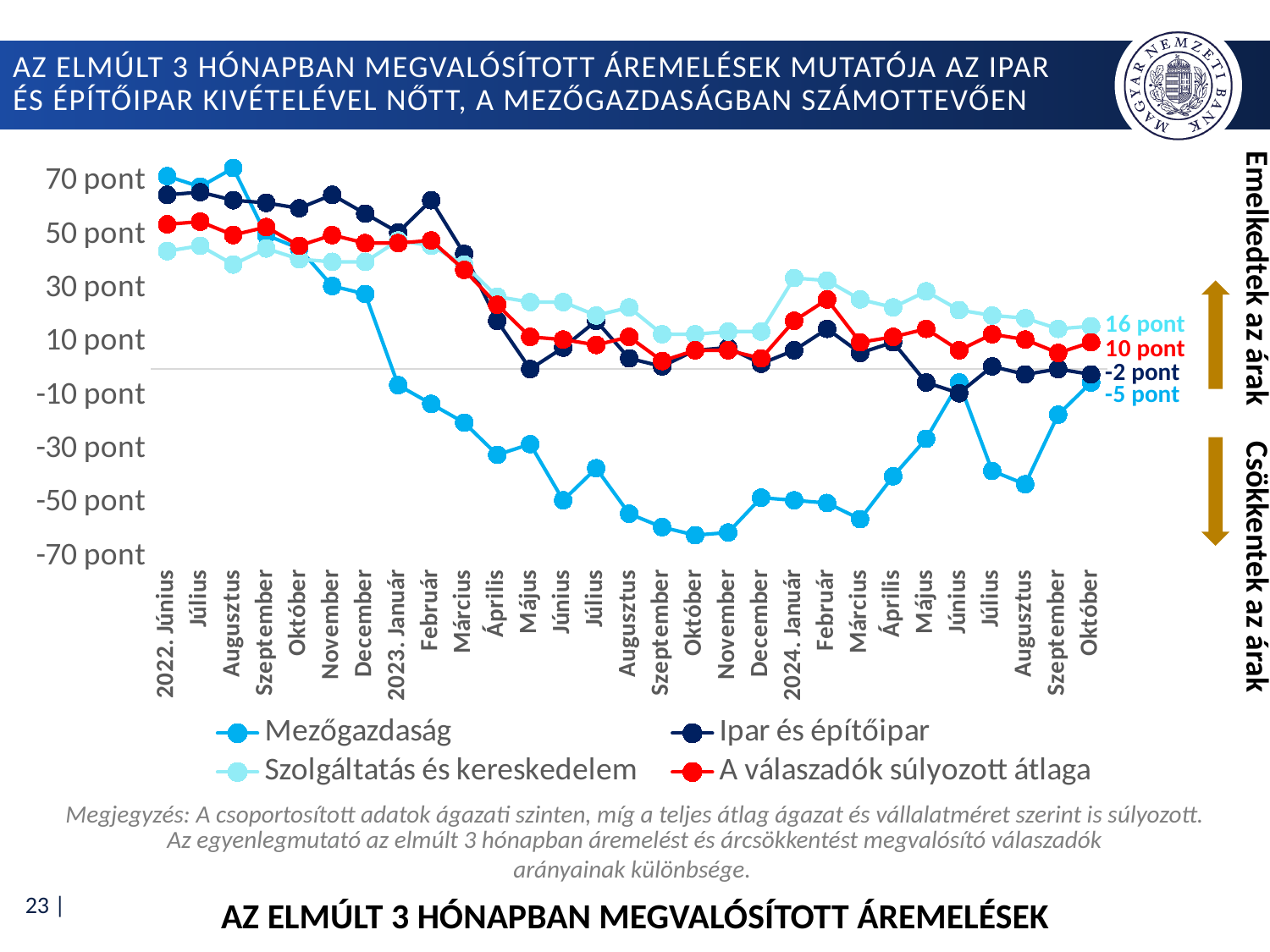
What is the value for Mezőgazdaság at the last point (Október 2024)? -5 pont What is the value for Ipar és építőipar at the last point (Október 2024)? -2 pont In Október 2023, which is larger: the value for Mezőgazdaság or the value for Ipar és építőipar? Ipar és építőipar What is the difference between the Október 2024 values of Szolgáltatás és kereskedelem and A válaszadók súlyozott átlaga? 6 pont What kind of chart is shown on the slide? Line chart How many series does the legend list? 4 Which series has the lowest value at the last point (Október 2024)? Mezőgazdaság What is the value for Szolgáltatás és kereskedelem in Október 2024, the last point on the chart? 16 pont What is the value for A válaszadók súlyozott átlaga at the last point (Október 2024)? 10 pont Is the value for Mezőgazdaság in 2022. Június greater or less than 50 pont? greater Is the value for Mezőgazdaság in Október 2023 greater or less than -50 pont? less Which series has the highest value at the last point (Október 2024)? Szolgáltatás és kereskedelem